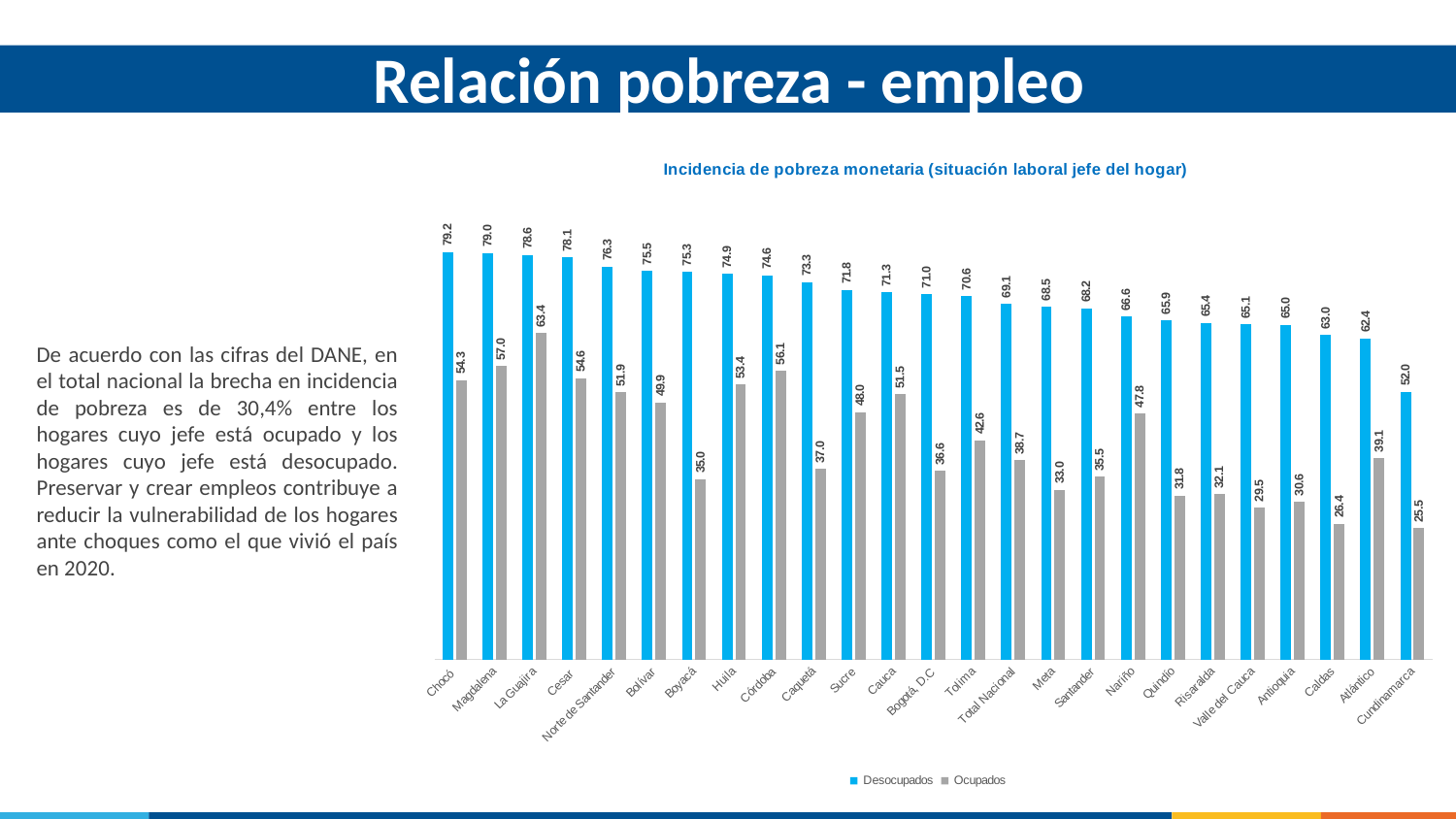
What is the difference between the Desocupados and Ocupados values for Chocó? 24.9 Do the Desocupados values rise or fall from left to right along the x axis? fall Which category has the highest Desocupados value? Chocó What is the difference between the Desocupados and Ocupados values for Total Nacional? 30.4 Which category has the lowest Ocupados value? Cundinamarca What is the Desocupados value for Cundinamarca? 52.0 What is the Ocupados value for Total Nacional? 38.7 How many series does the legend list? 2 Which has a larger Ocupados value, La Guajira or Magdalena? La Guajira What is the Desocupados value for Chocó? 79.2 What kind of chart is shown? bar chart How many categories are shown on the x axis? 25